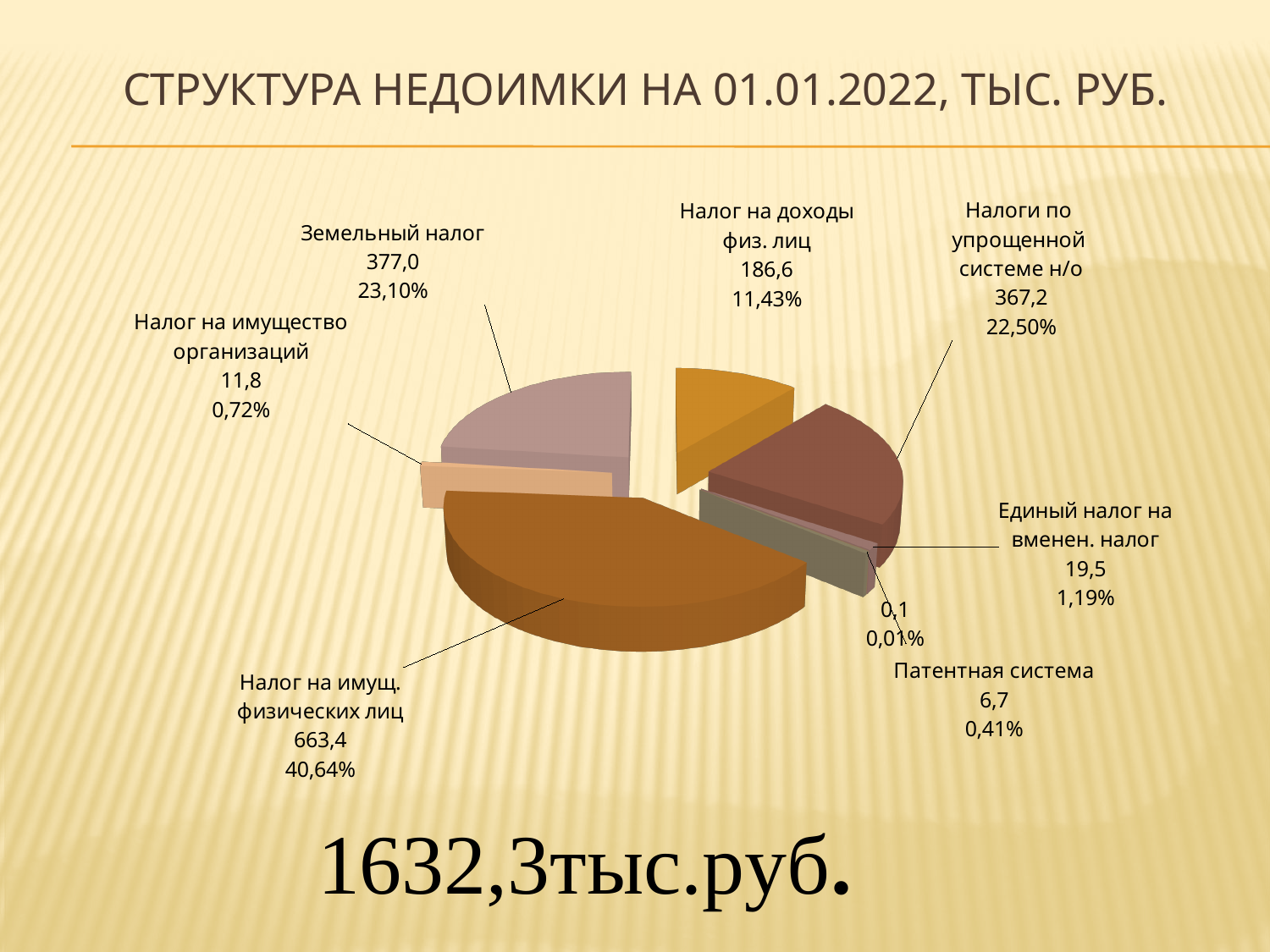
Which category has the largest slice of the pie? Налог на имущ. физических лиц What is the value for Единый налог на вменен. налог? 19,5 What share of the pie does Земельный налог represent? 23,10% What is the value for Налоги по упрощенной системе н/о? 367,2 Which named category has the smallest value? Патентная система What is the value for Налог на имущ. физических лиц? 663,4 What share of the pie does Налог на доходы физ. лиц represent? 11,43% What is the difference between the values for Налог на имущ. физических лиц and Земельный налог? 286,4 Which is larger: Земельный налог or Налоги по упрощенной системе н/о? Земельный налог What is the title of the chart? СТРУКТУРА НЕДОИМКИ НА 01.01.2022, ТЫС. РУБ. What kind of chart is shown on the slide? pie chart What is the total shown below the chart? 1632,3 тыс.руб.